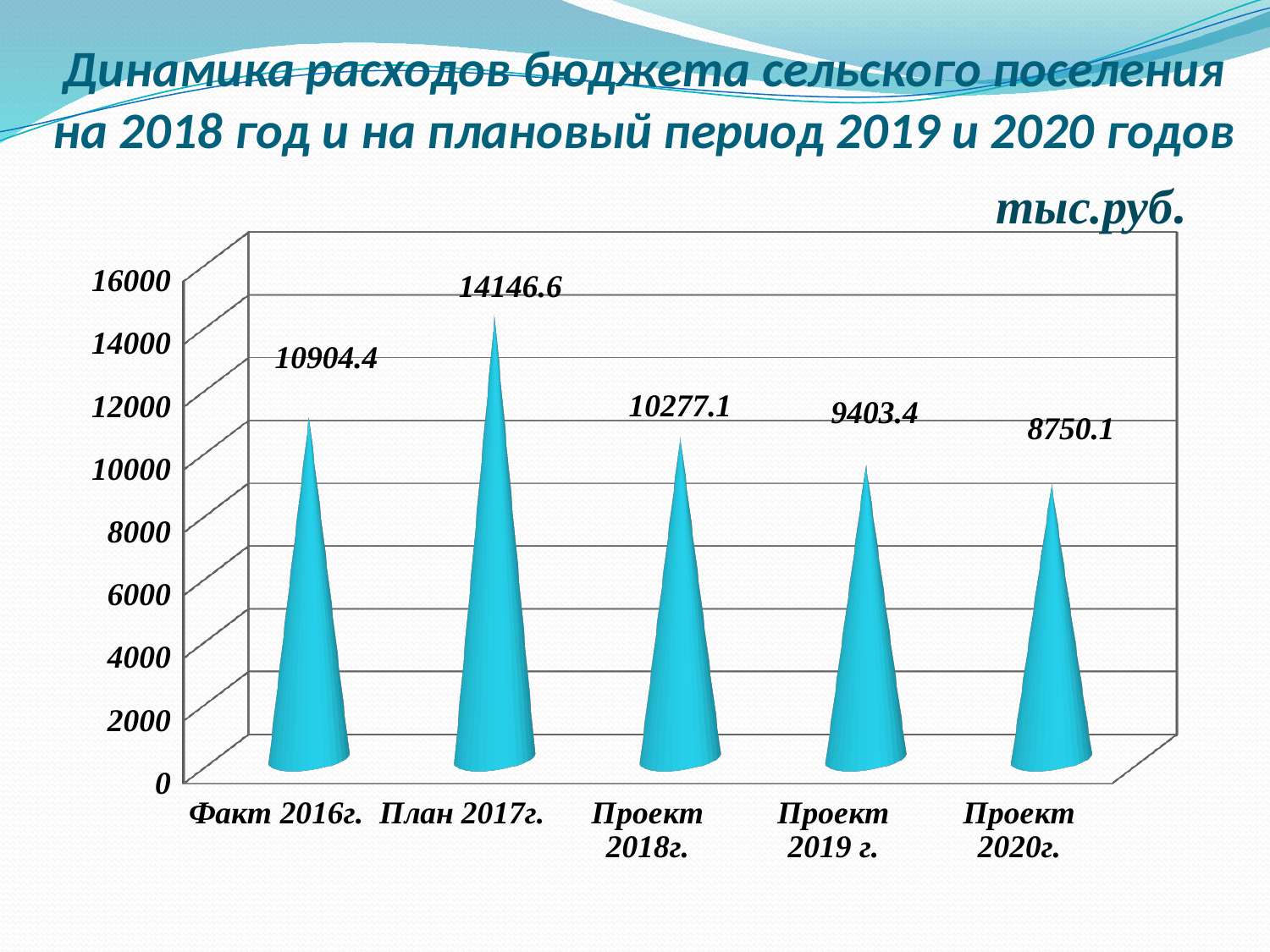
What is the difference between the values for План 2017г. and Факт 2016г.? 3242.2 What kind of chart is shown on the slide? bar chart Which is larger, the value for Факт 2016г. or the value for Проект 2018г.? Факт 2016г. Which category has the highest value? План 2017г. What is the difference between the values for Проект 2019 г. and Проект 2020г.? 653.3 Do the values rise or fall from Проект 2018г. to Проект 2020г.? fall Is the value for Проект 2019 г. greater or less than 10000? less What is the value for План 2017г.? 14146.6 What is the value for Факт 2016г.? 10904.4 How many categories are shown on the x axis? 5 What is the value for Проект 2020г.? 8750.1 Which category has the lowest value? Проект 2020г.